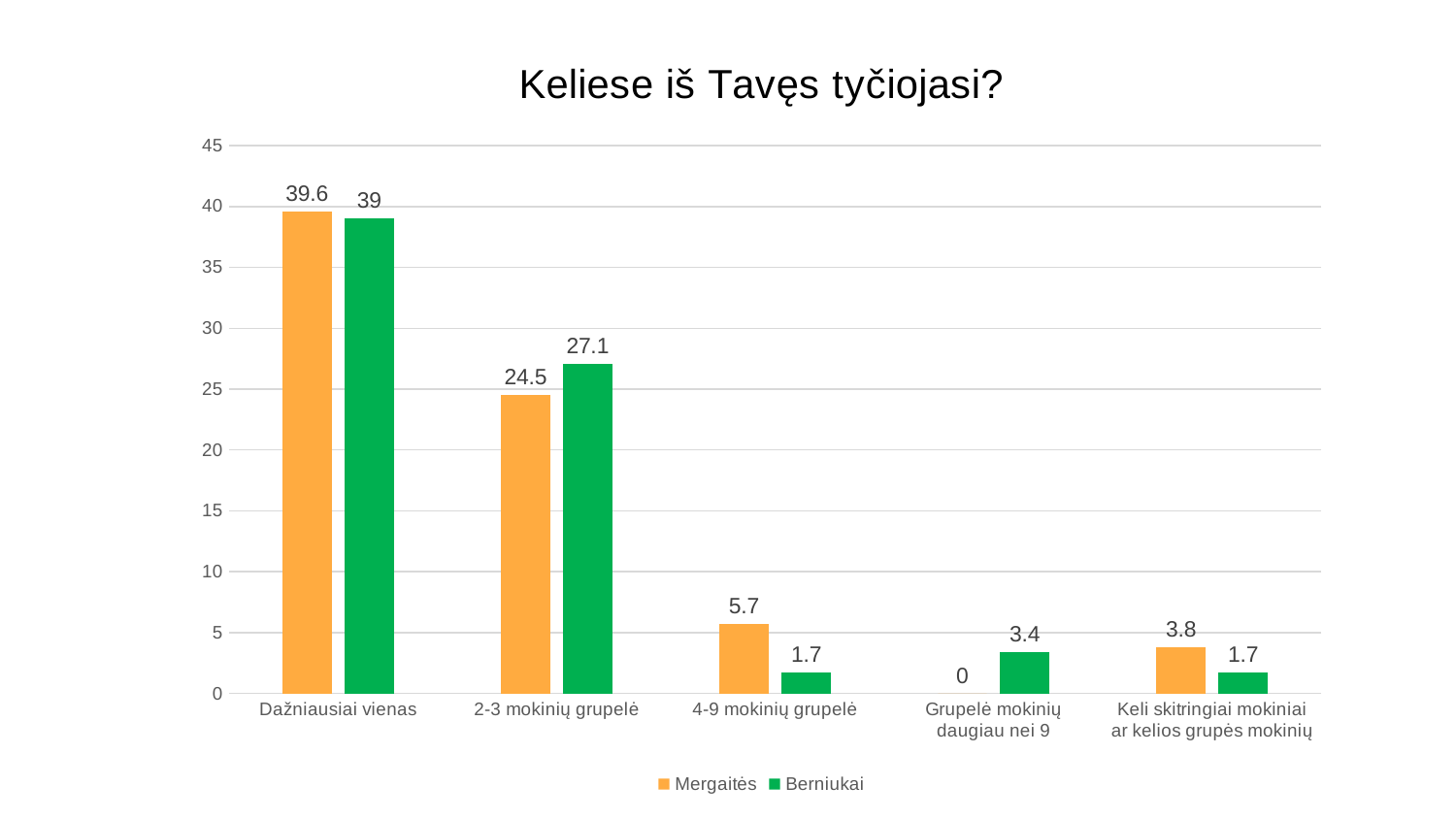
Which colour represents the Berniukai series? Green What kind of chart is shown on the slide? Bar chart Which category has the highest value for Berniukai? Dažniausiai vienas Which category has the lowest value for Mergaitės? Grupelė mokinių daugiau nei 9 What is the difference between the Berniukai and Mergaitės values in the '2-3 mokinių grupelė' category? 2.6 What is the title of the chart? Keliese iš Tavęs tyčiojasi? What is the value for Mergaitės in the 'Dažniausiai vienas' category? 39.6 What is the value for Mergaitės in the 'Grupelė mokinių daugiau nei 9' category? 0 What is the value for Berniukai in the '2-3 mokinių grupelė' category? 27.1 How many categories are shown on the x axis? 5 How many series does the legend list? 2 In the '4-9 mokinių grupelė' category, which series has the larger value, Mergaitės or Berniukai? Mergaitės